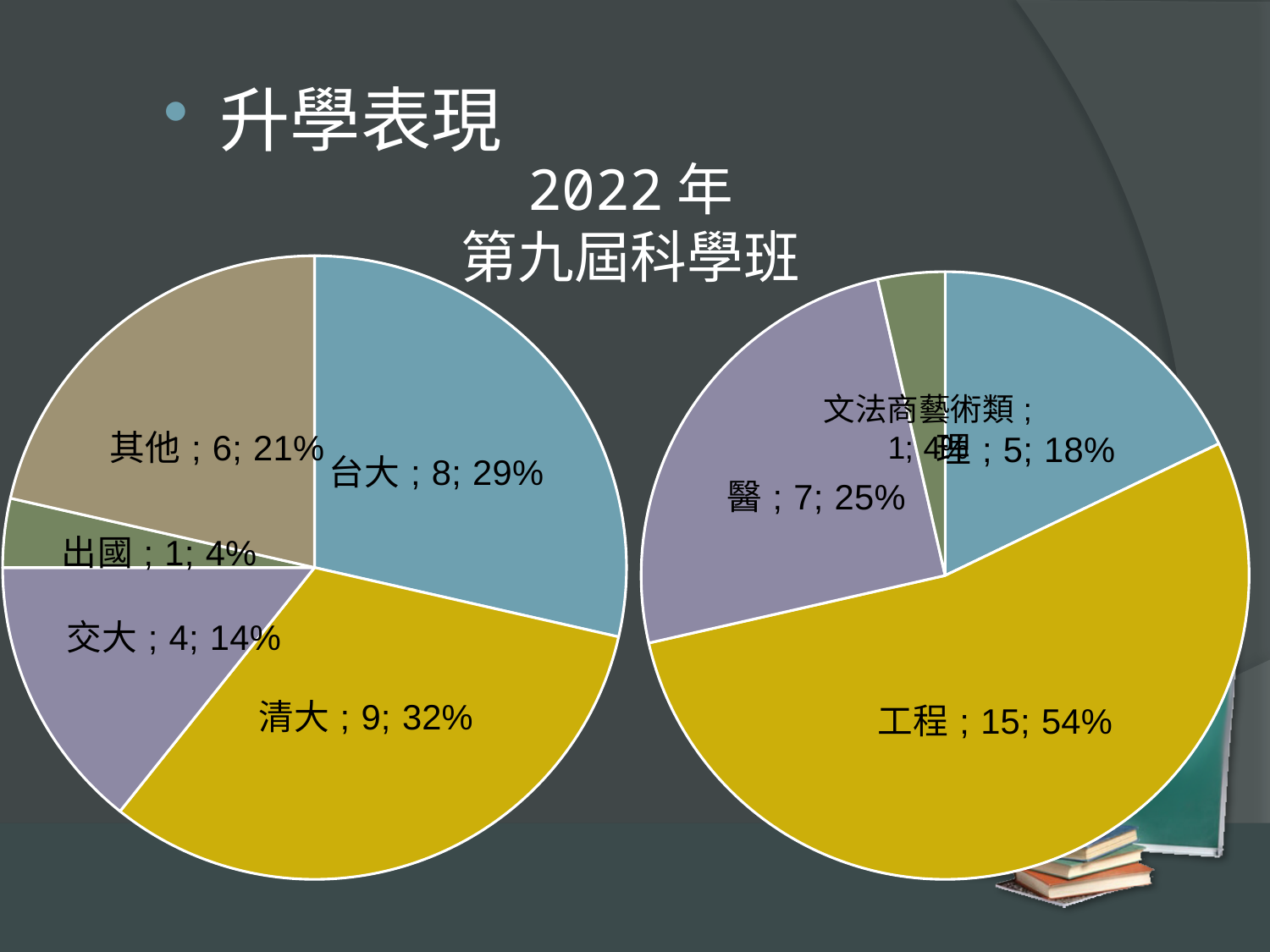
In the right pie chart, which category has the largest slice? 工程 In the right pie chart, what share of the pie does 醫 represent? 25% How many slices does the right pie chart have? 4 In the left pie chart, how many students went to 清大? 9 In the left pie chart, what is the difference between the number for 台大 and the number for 交大? 4 In the left pie chart, which category has the smallest slice? 出國 In the right pie chart, which is larger, 醫 or 理? 醫 In the left pie chart, which category has the largest slice? 清大 How many slices does the left pie chart have? 5 What kind of chart is the left chart on the slide? pie chart In the left pie chart, what share of the pie does 台大 represent? 29% In the right pie chart, how many students are in 工程? 15